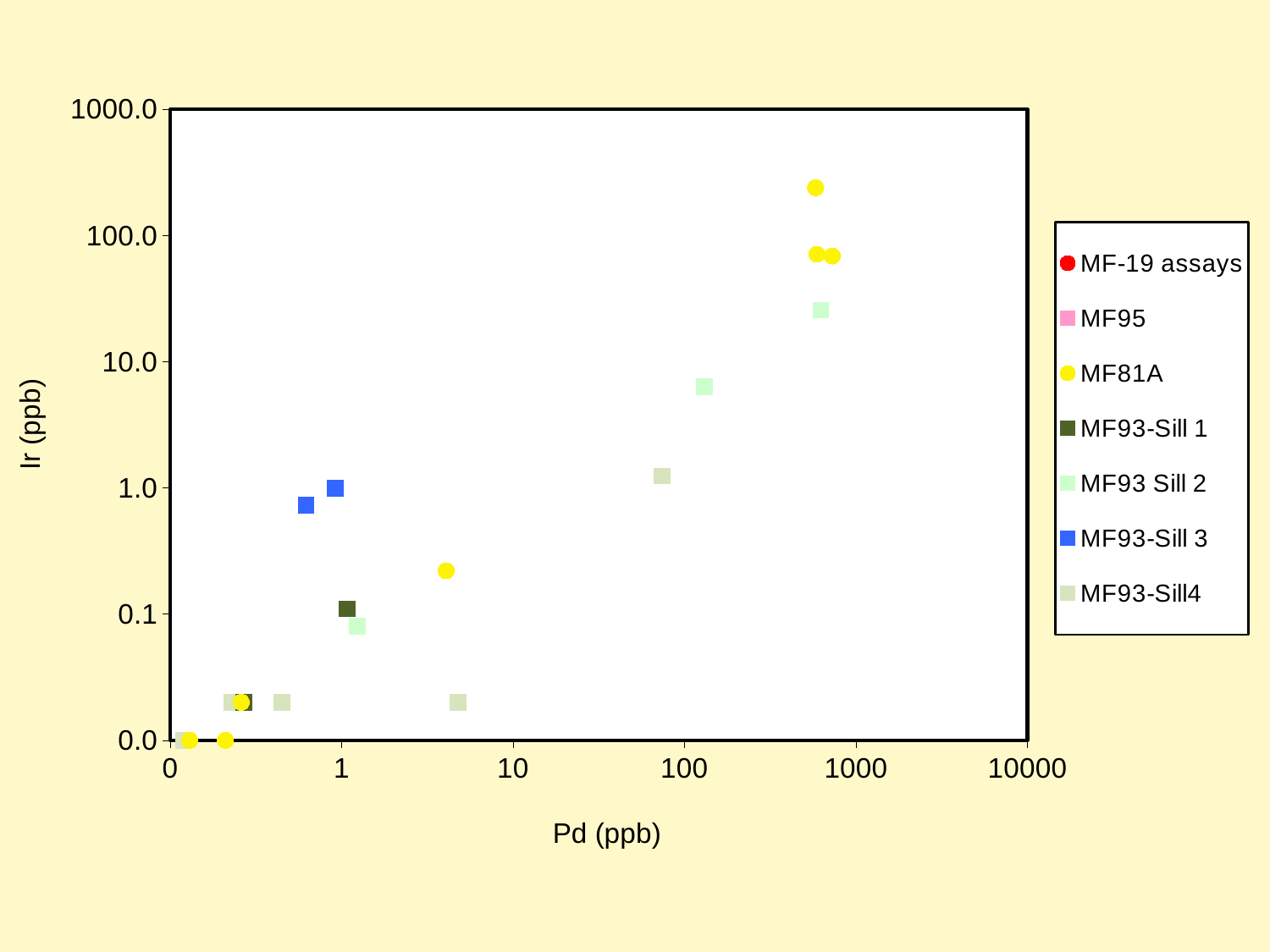
Near Pd = 1000, which series has the higher Ir (ppb) values, MF81A or MF93 Sill 2? MF81A What kind of chart is shown on the slide? scatter chart Overall, do Ir (ppb) values rise or fall as Pd (ppb) increases? rise How many series does the legend list? 7 Is the Ir (ppb) value of the highest MF93 Sill 2 point greater or less than 100.0? less What is the label of the x axis? Pd (ppb) How many MF93-Sill 3 points are plotted? 2 Are the Pd (ppb) values of the MF93-Sill 3 points greater or less than 10? less Which series has the point with the highest Ir (ppb) value? MF81A What is the label of the y axis? Ir (ppb) Is the Ir (ppb) value of the highest MF81A point greater or less than 100.0? greater